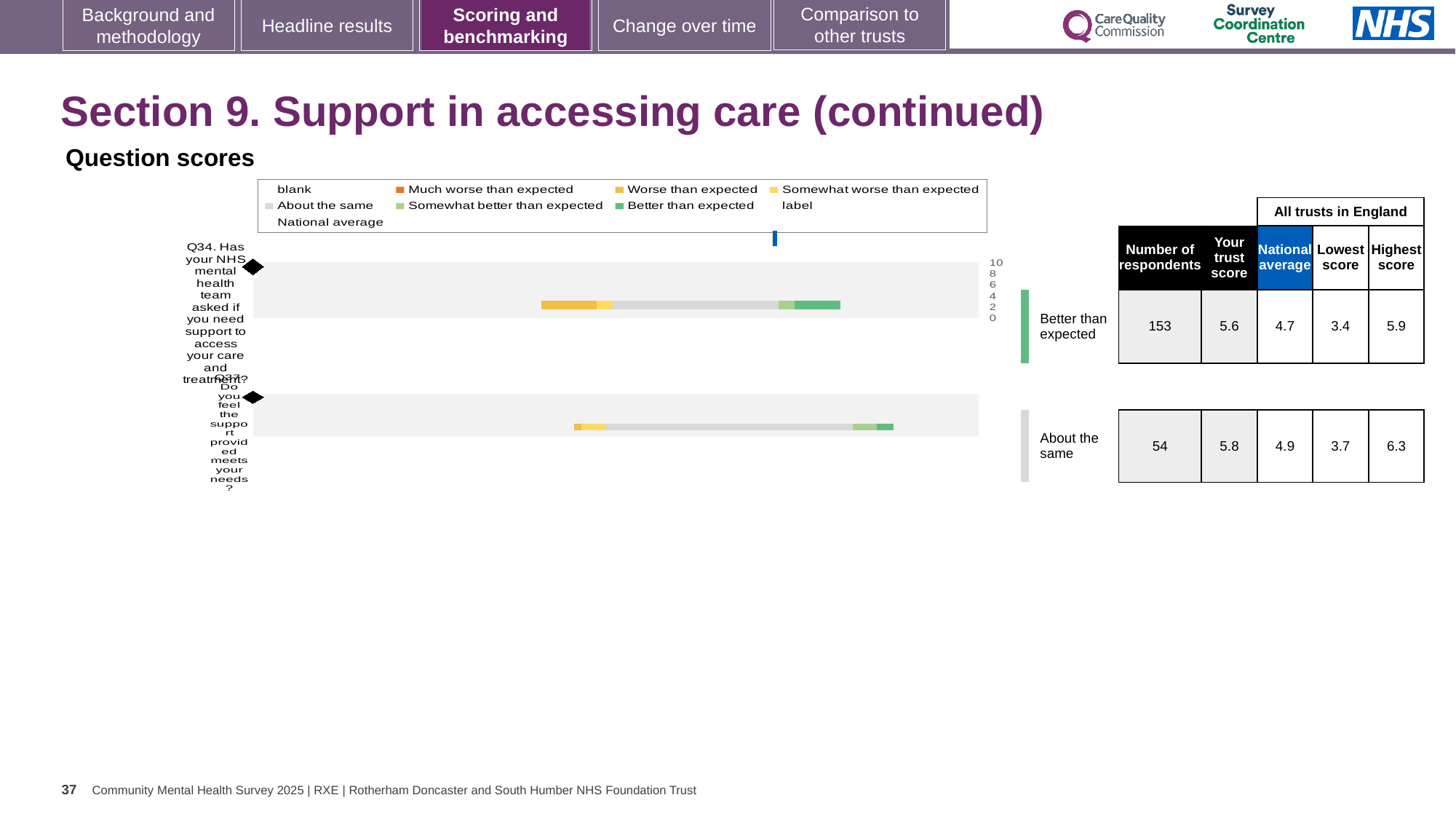
What is the trust score for Q34 (Has your NHS mental health team asked if you need support to access your care and treatment)? 5.6 What is the national average score for Q37? 4.9 What type of chart is used to show the question scores on this slide? bar chart How many respondents answered Q34? 153 Which question has the higher trust score, Q34 or Q37? Q37 What is the highest score across all trusts in England for Q34? 5.9 Which benchmarking category is Q37 placed in? About the same What is the trust score for Q37 (Do you feel the support provided meets your needs)? 5.8 How many entries does the legend of the question scores chart list? 9 What is the difference between the trust score and the national average for Q34? 0.9 How many questions (categories) are plotted in the question scores chart? 2 Which benchmarking category is Q34 placed in? Better than expected